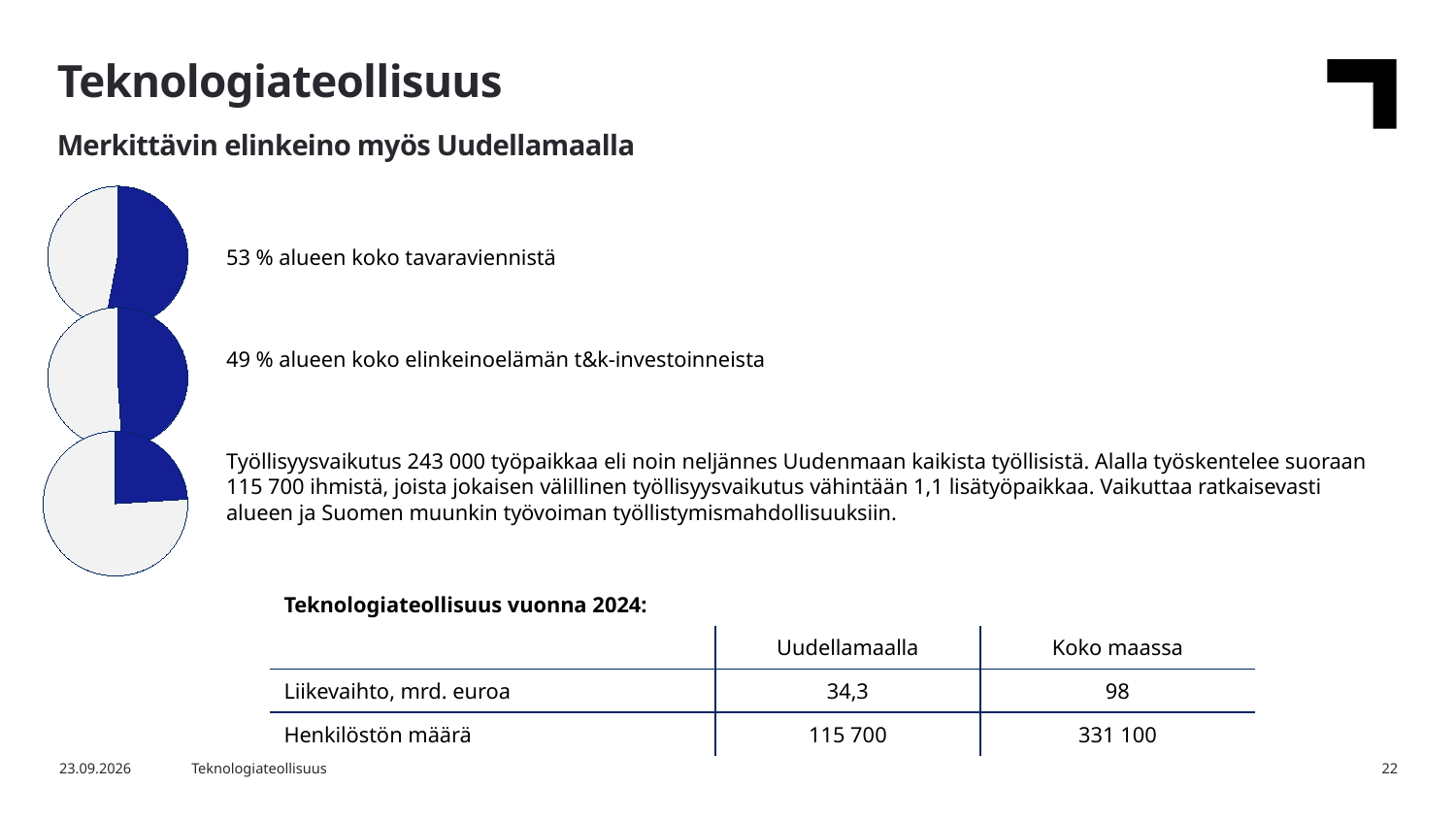
In the top pie chart, what share of the region's total goods exports does the blue slice represent? 53 % Which pie chart has the larger blue slice, the top one (goods exports) or the middle one (R&D investments)? The top one (goods exports) In the middle pie chart, what share of the region's business R&D investments does the blue slice represent? 49 % How many slices does each pie chart have? 2 What kind of charts are shown on the left side of the slide? Pie charts How many pie charts are shown on the slide? 3 Which of the three pie charts has the smallest blue slice? The bottom one (employment effect) What is the difference in percentage points between the blue slice of the top pie chart and the blue slice of the middle pie chart? 4 percentage points Is the blue slice of the bottom pie chart greater or less than half of the pie? less What colour is used for the highlighted slice in each pie chart? Blue